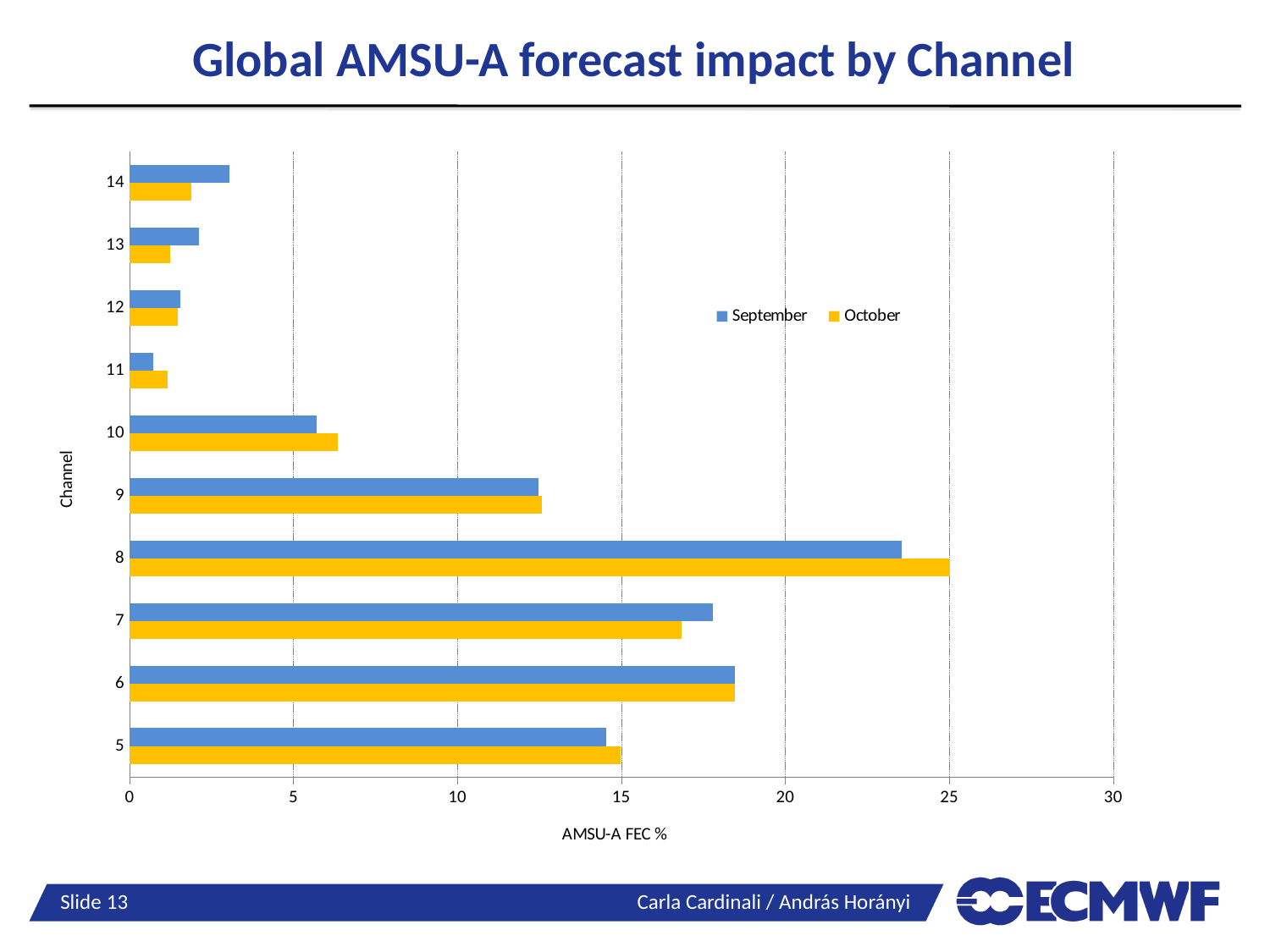
Is the September value for channel 14 greater or less than 5? less Which channel has the highest September value? 8 For channel 10, which is larger, the September value or the October value? October How many channels are plotted on the chart? 10 Which channel has the lowest September value? 11 What is the label on the horizontal axis of the chart? AMSU-A FEC % What kind of chart is shown on the slide? bar chart For channel 14, which is larger, the September value or the October value? September Is the October value for channel 10 greater or less than 5? greater Is the September value for channel 8 greater or less than 20? greater Which channel has the highest October value? 8 How many series does the legend list? 2